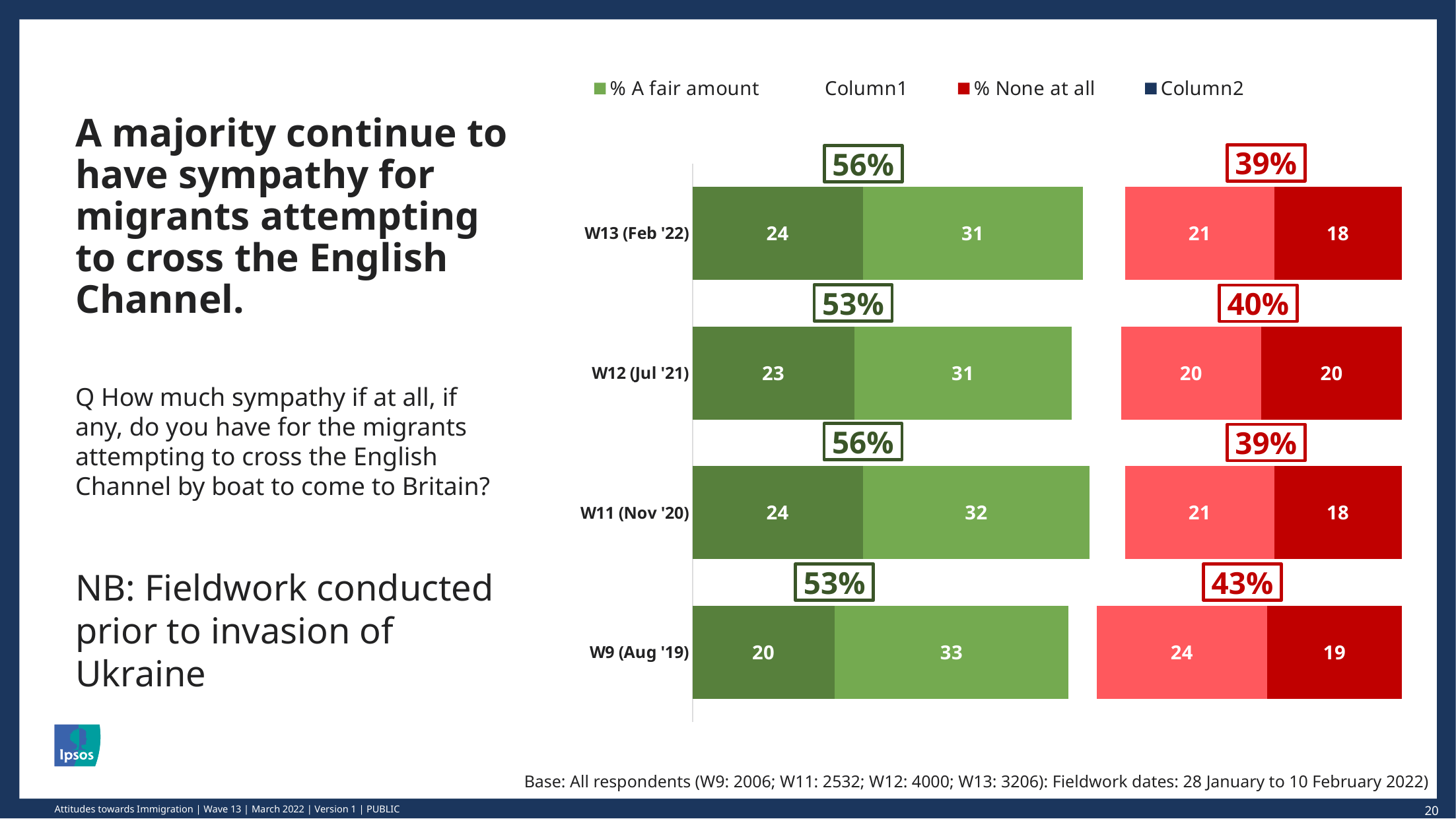
What is the first entry listed in the chart legend? % A fair amount What is the boxed green total shown above the W13 (Feb '22) bar? 56% How many waves (categories) are plotted on the chart? 4 What kind of chart is shown on the slide? bar chart What value is printed in the light green segment for W9 (Aug '19)? 33 What is the boxed red total shown above the W9 (Aug '19) bar? 43% Which wave has the highest boxed red total? W9 (Aug '19) What value is printed in the dark red segment for W11 (Nov '20)? 18 How many entries does the chart legend list? 4 Which is larger for W12 (Jul '21): the boxed green total or the boxed red total? the boxed green total (53%) What value is printed in the dark green segment for W12 (Jul '21)? 23 What is the difference between the boxed red totals for W9 (Aug '19) and W13 (Feb '22)? 4 percentage points